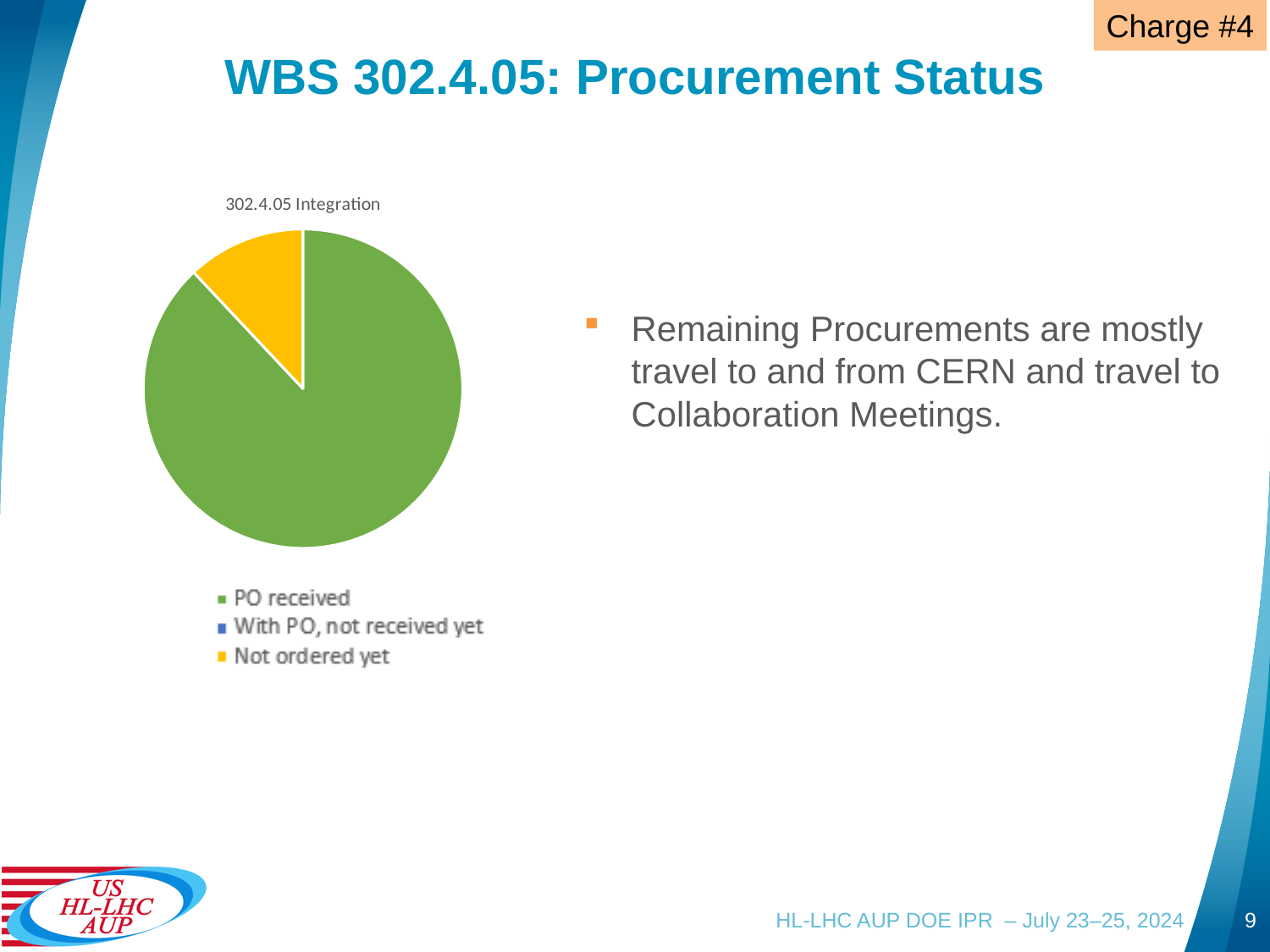
What is the title of the pie chart? 302.4.05 Integration Which category has the largest slice of the pie chart? PO received How many entries does the legend of the pie chart list? 3 Which is larger in the pie chart, the slice for PO received or the slice for Not ordered yet? PO received Does the PO received slice take up more or less than half of the pie chart? more What kind of chart is shown on the slide? pie chart What colour is the slice for Not ordered yet in the pie chart? yellow